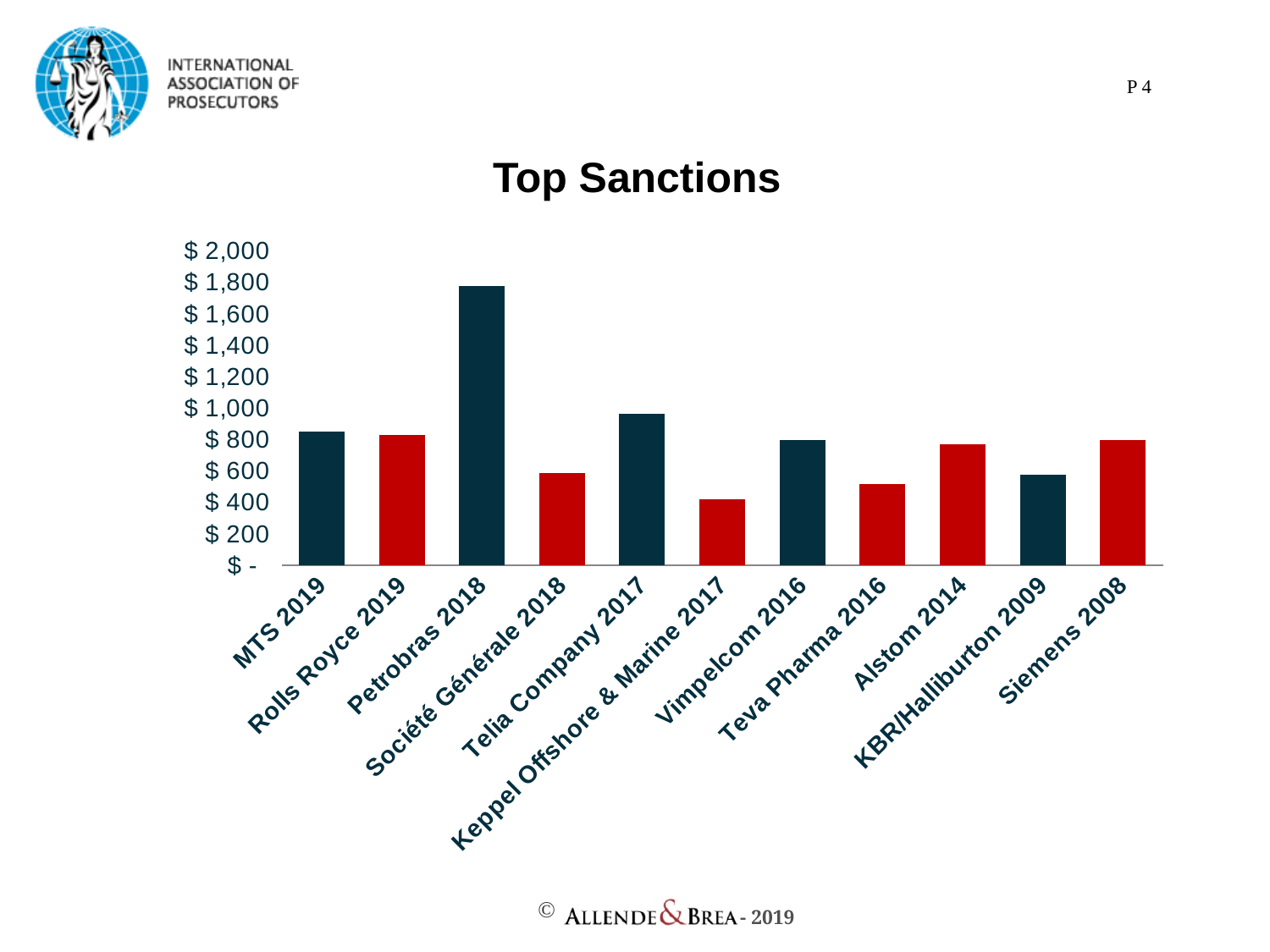
How many companies (categories) are shown on the x axis of the chart? 11 Which company has the lowest sanction value in the chart? Keppel Offshore & Marine 2017 Which company has the highest sanction value in the chart? Petrobras 2018 Is the value for Teva Pharma 2016 greater or less than $ 600? less Which is larger, the value for Petrobras 2018 or the value for Siemens 2008? Petrobras 2018 Which is larger, the value for Telia Company 2017 or the value for Société Générale 2018? Telia Company 2017 Is the value for Keppel Offshore & Marine 2017 greater or less than $ 600? less Is the value for MTS 2019 greater or less than $ 800? greater What is the title of the chart? Top Sanctions What two colours are used for the bars in the chart? dark blue and red What kind of chart is shown on the slide? bar chart